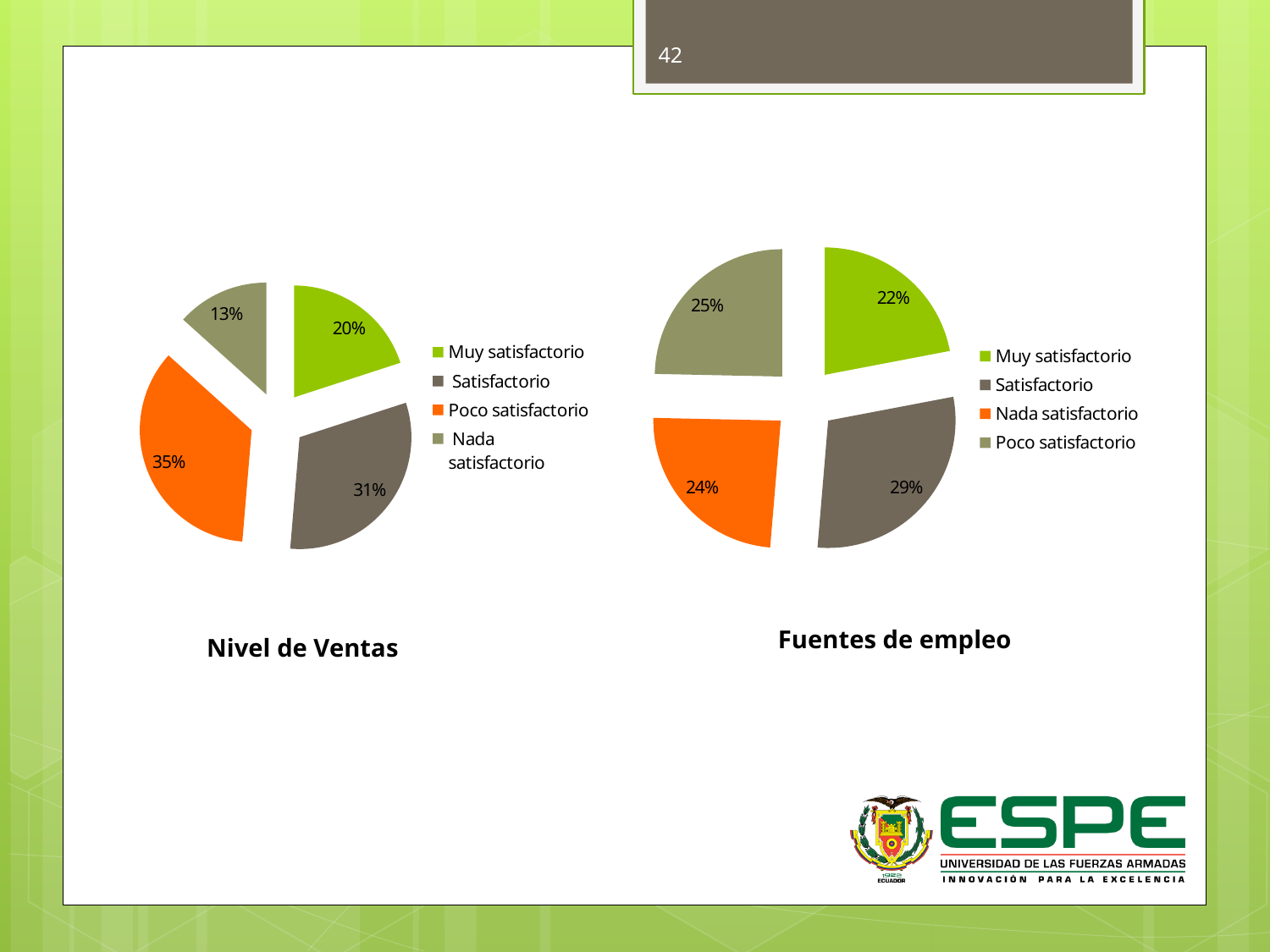
In the Nivel de Ventas chart, which category has the smallest slice? Nada satisfactorio In the Nivel de Ventas chart, what share is labelled for Poco satisfactorio? 35% How many categories does the legend of the Nivel de Ventas chart list? 4 In the Nivel de Ventas chart, what share is labelled for Muy satisfactorio? 20% In the Fuentes de empleo chart, what is the difference between the Satisfactorio and Muy satisfactorio shares? 7% In the Fuentes de empleo chart, which category has the smallest slice? Muy satisfactorio In the Fuentes de empleo chart, what share is labelled for Satisfactorio? 29% In the Fuentes de empleo chart, which category has the largest slice? Satisfactorio In the Nivel de Ventas chart, what is the difference between the Satisfactorio and Nada satisfactorio shares? 18% In the Nivel de Ventas chart, which category has the largest slice? Poco satisfactorio What type of chart is the Fuentes de empleo chart? Pie chart In the Fuentes de empleo chart, what share is labelled for Nada satisfactorio? 24%